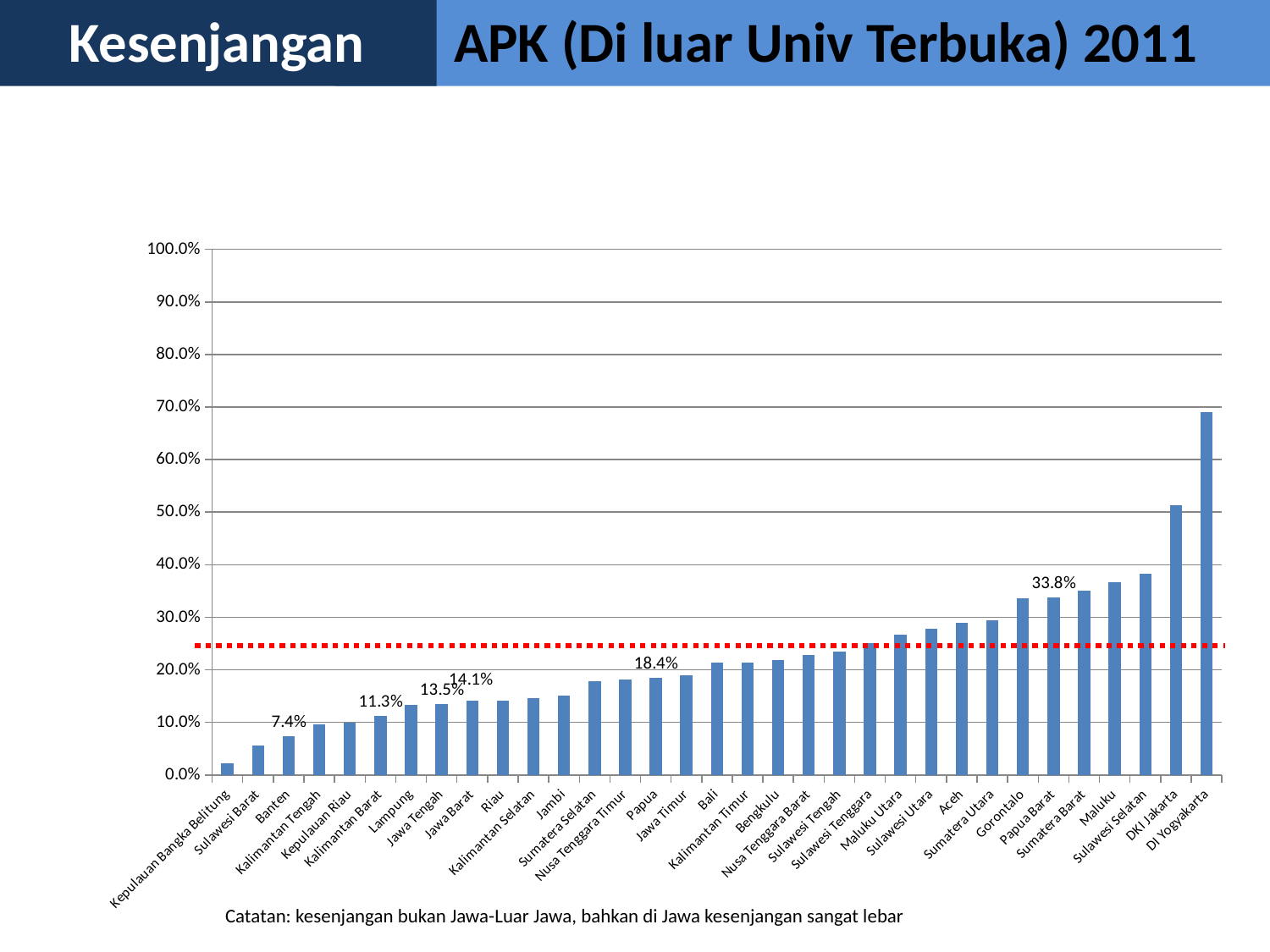
Which has a larger APK value, DKI Jakarta or DI Yogyakarta? DI Yogyakarta What is the difference between the APK values of Jawa Barat and Jawa Tengah? 0.6% Is the value for Maluku greater or less than 40.0%? less What is the difference between the APK values of Papua Barat and Banten? 26.4% What kind of chart is shown on the slide? bar chart Do the bar values rise or fall from left to right along the x axis? rise What is the APK value shown for Papua Barat? 33.8% What is the APK value shown for Papua? 18.4% Which province has the lowest APK value in the chart? Kepulauan Bangka Belitung How many provinces are shown in the chart? 33 What is the APK value shown for Banten? 7.4% Which province has the highest APK value in the chart? DI Yogyakarta